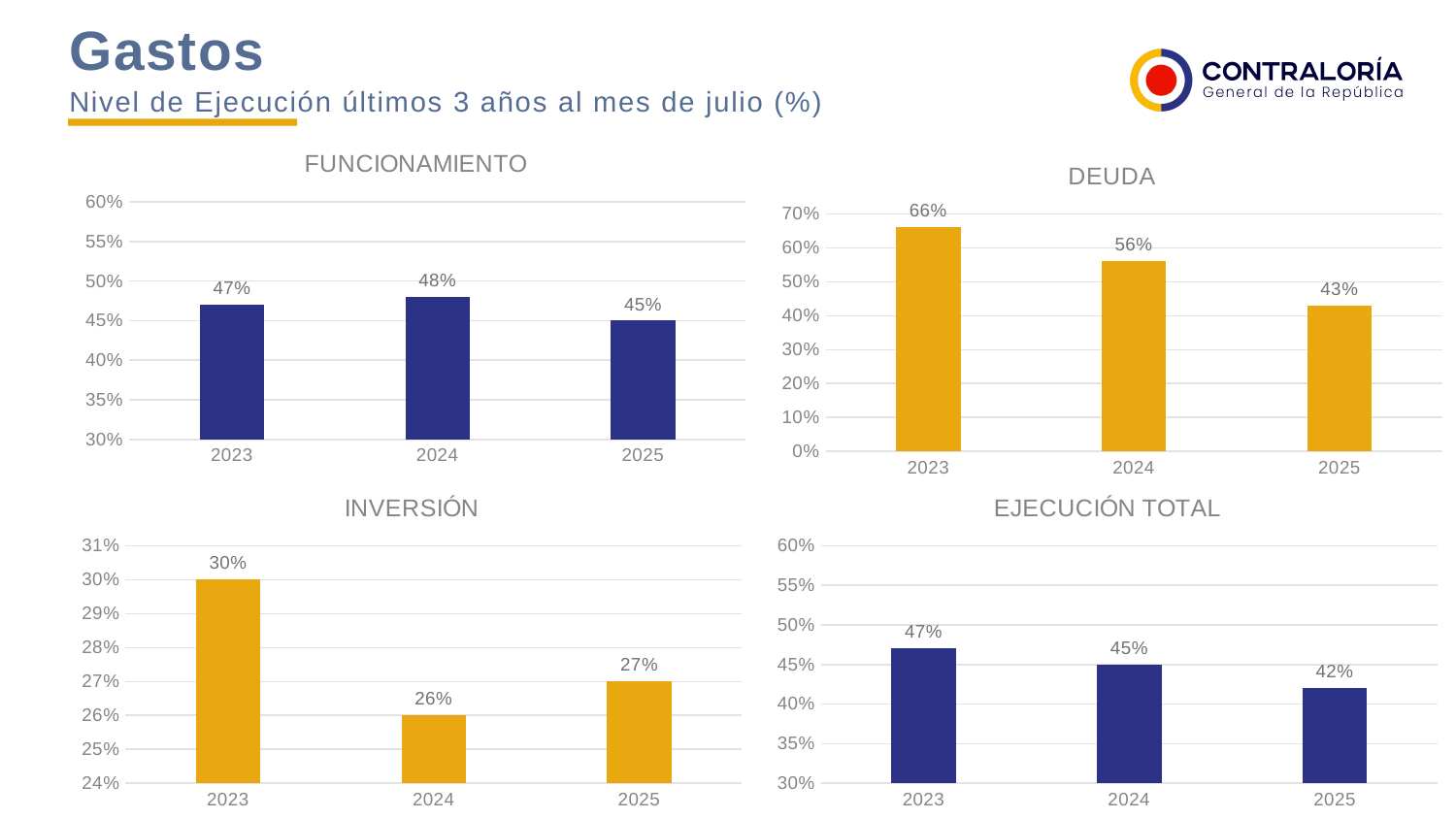
In the DEUDA chart, do the values rise or fall from 2023 to 2025? fall In the INVERSIÓN chart, which year has the highest value? 2023 In the FUNCIONAMIENTO chart, which is larger, the value for 2024 or the value for 2025? 2024 In the DEUDA chart, what is the value for 2023? 66% In the DEUDA chart, which year has the lowest value? 2025 In the INVERSIÓN chart, what is the value for 2025? 27% In the DEUDA chart, what is the difference between the 2023 and 2025 values? 23% In the EJECUCIÓN TOTAL chart, what is the difference between the 2023 and 2024 values? 2% What kind of chart is the INVERSIÓN chart? bar chart In the EJECUCIÓN TOTAL chart, what is the value for 2025? 42% In the FUNCIONAMIENTO chart, what is the value for 2024? 48% How many bars does the EJECUCIÓN TOTAL chart have? 3